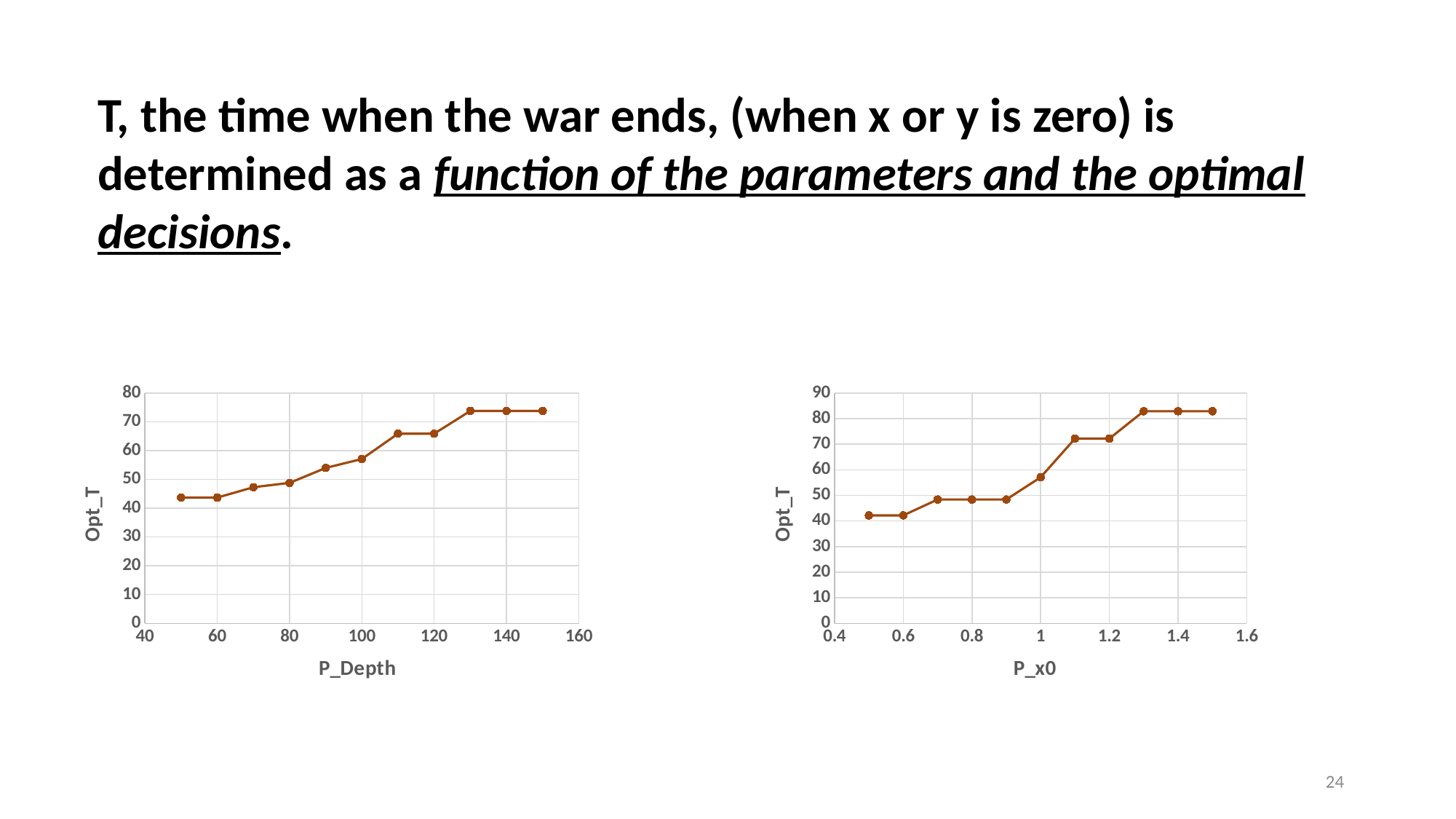
In the right chart (P_x0), is the value of Opt_T at P_x0 1.5 greater or less than 80? greater What kind of chart is the left chart with P_Depth on the x axis? line chart In the left chart (P_Depth), which has the larger Opt_T value: P_Depth 50 or P_Depth 150? P_Depth 150 In the left chart (P_Depth), does Opt_T generally rise or fall as P_Depth increases? rise In the left chart (P_Depth), is the value of Opt_T at P_Depth 50 greater or less than 50? less What is the y-axis label of the right chart with P_x0 on the x axis? Opt_T In the left chart (P_Depth), is the value of Opt_T at P_Depth 150 greater or less than 70? greater In the left chart (P_Depth), how many data points are plotted? 11 In the right chart (P_x0), how many data points are plotted? 11 In the right chart (P_x0), does Opt_T generally rise or fall as P_x0 increases? rise